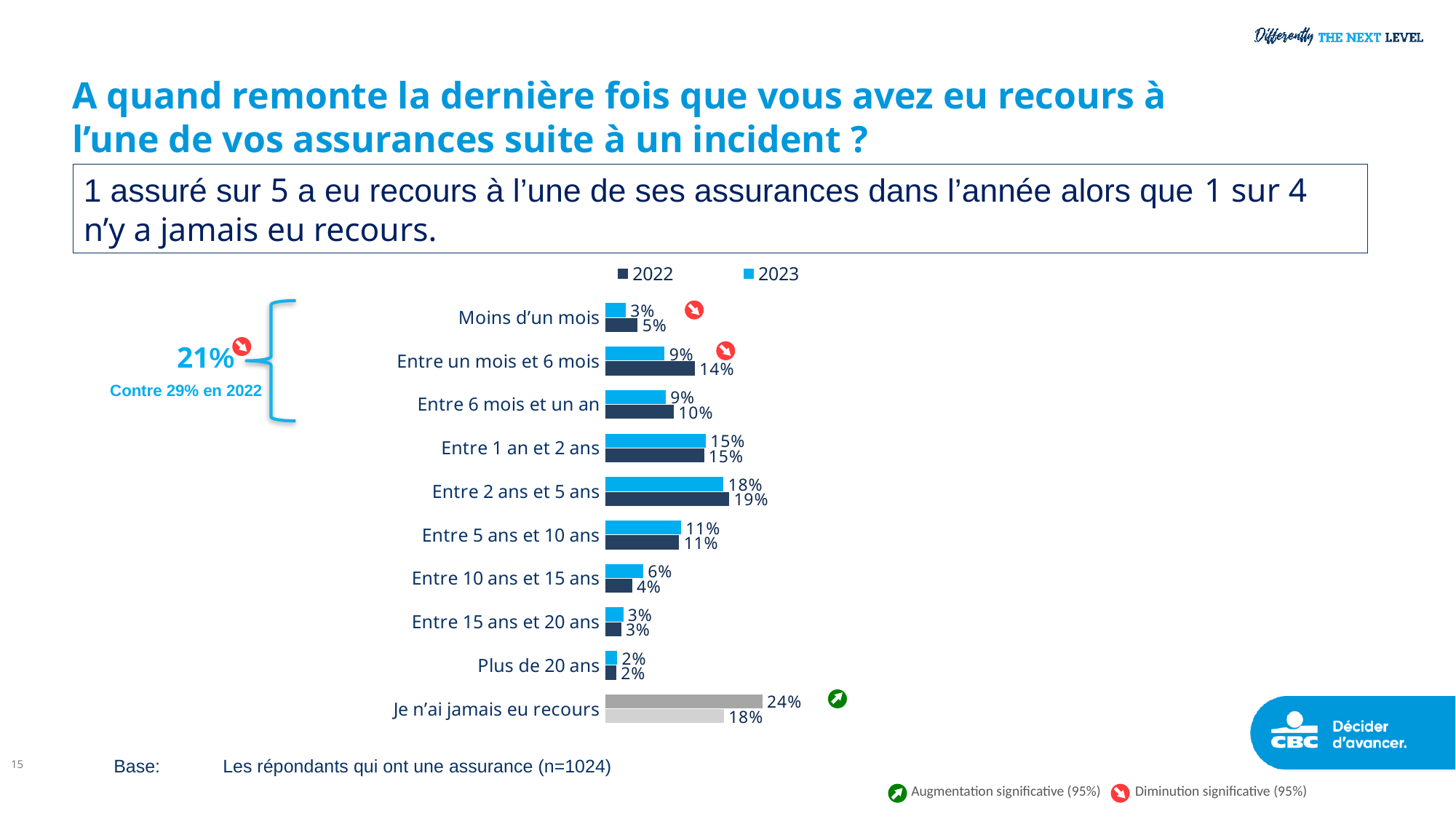
What are the two series named in the legend? 2022 and 2023 How many categories are shown in the chart? 10 What is the 2022 value for "Entre 2 ans et 5 ans"? 19% Which category has the highest 2023 value? Je n'ai jamais eu recours What is the 2023 value for "Entre un mois et 6 mois"? 9% For "Moins d'un mois", which year has the larger value, 2022 or 2023? 2022 What is the 2023 value for "Je n'ai jamais eu recours"? 24% How many series does the legend list? 2 What is the 2022 value for "Entre un mois et 6 mois"? 14% What kind of chart is shown on the slide? Bar chart Which category has the lowest 2022 value? Plus de 20 ans What is the difference between the 2023 and 2022 values for "Je n'ai jamais eu recours"? 6%